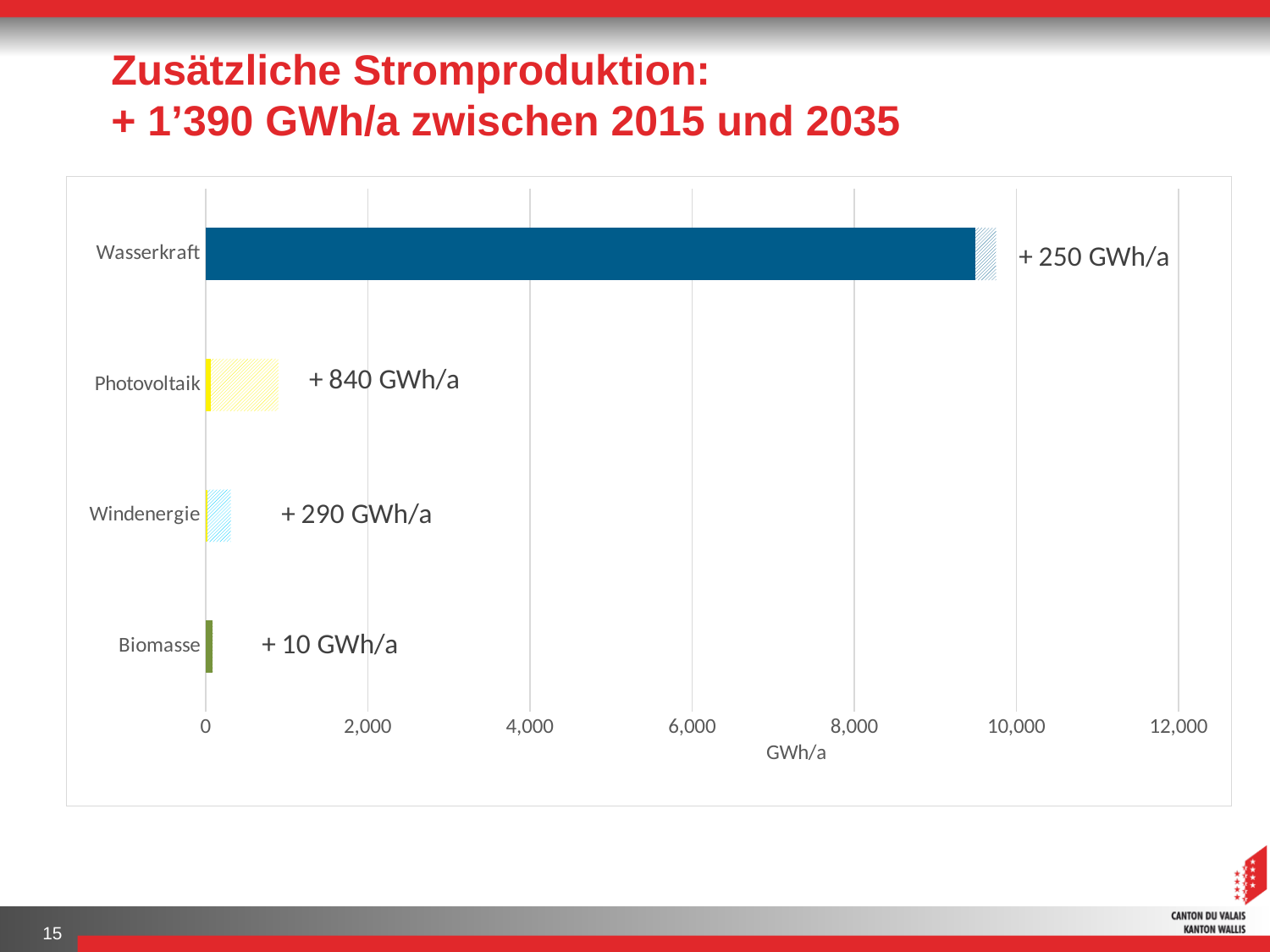
How many categories are shown in the chart? 4 What additional production is labelled for Windenergie? + 290 GWh/a Which category has the longest bar in the chart? Wasserkraft How much larger is the labelled additional production for Photovoltaik than for Wasserkraft? 590 GWh/a Is the labelled additional production larger for Windenergie or for Biomasse? Windenergie What additional production is labelled for Biomasse? + 10 GWh/a Which category has the smallest labelled additional production? Biomasse What additional production is labelled for Photovoltaik? + 840 GWh/a What additional production is labelled for Wasserkraft? + 250 GWh/a What kind of chart is shown on the slide? bar chart Is the value of the Wasserkraft bar greater or less than 8,000? greater Which category has the largest labelled additional production? Photovoltaik